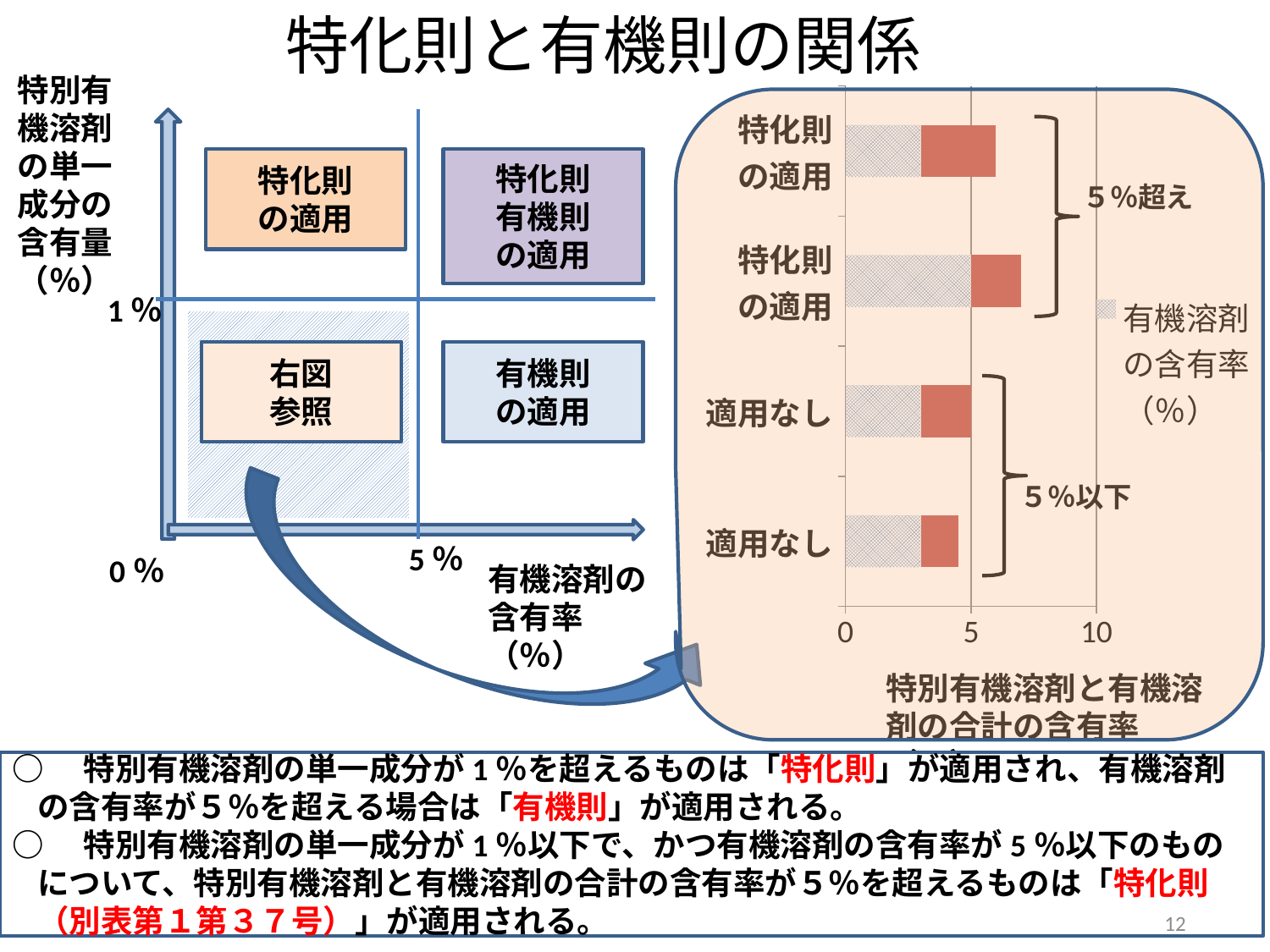
What legend entry is shown next to the bar chart on the right? 有機溶剤の含有率（%） In the bar chart on the right, is the total value of the second bar from the top greater or less than 10? less In the bar chart on the right, is the total value of the bottom bar (適用なし) greater or less than 5? less In the bar chart on the right, is the total value of the top bar (特化則の適用) greater or less than 5? greater What kind of chart is shown on the right side of the slide? bar chart In the bar chart on the right, which is longer: the second bar from the top or the bottom bar? the second bar from the top In the bar chart on the right, which is longer: the top bar or the second bar from the top? the second bar from the top In the bar chart on the right, which bar is the longest? the second bar from the top (特化則の適用) How many bars are plotted in the bar chart on the right? 4 What is the highest tick value shown on the horizontal axis of the bar chart on the right? 10